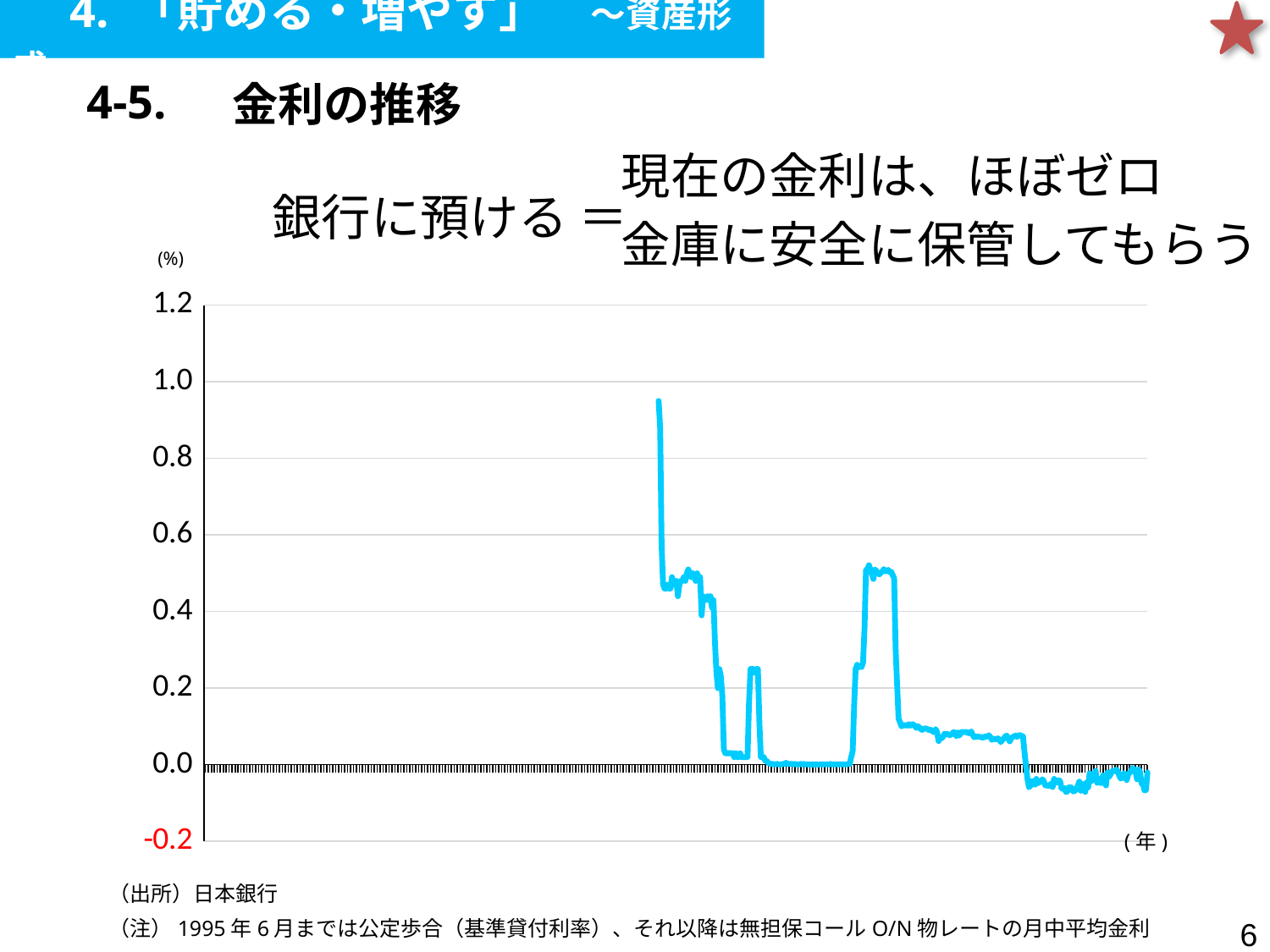
What is the lowest value labelled on the vertical axis? -0.2 What is the title of the chart section on the slide? 4-5. 金利の推移 At the far right end of the chart, is the value greater or less than 0.2? less What source is cited for the chart data? 日本銀行 Is the highest value reached by the line greater or less than 0.8? greater Overall, does the interest rate rise or fall from the left to the right of the chart? fall What kind of chart is shown on the slide? line chart Is the highest value reached by the line greater or less than 1.0? less What label is shown for the horizontal axis? (年) What unit is shown for the vertical axis? % What is the highest value labelled on the vertical axis? 1.2